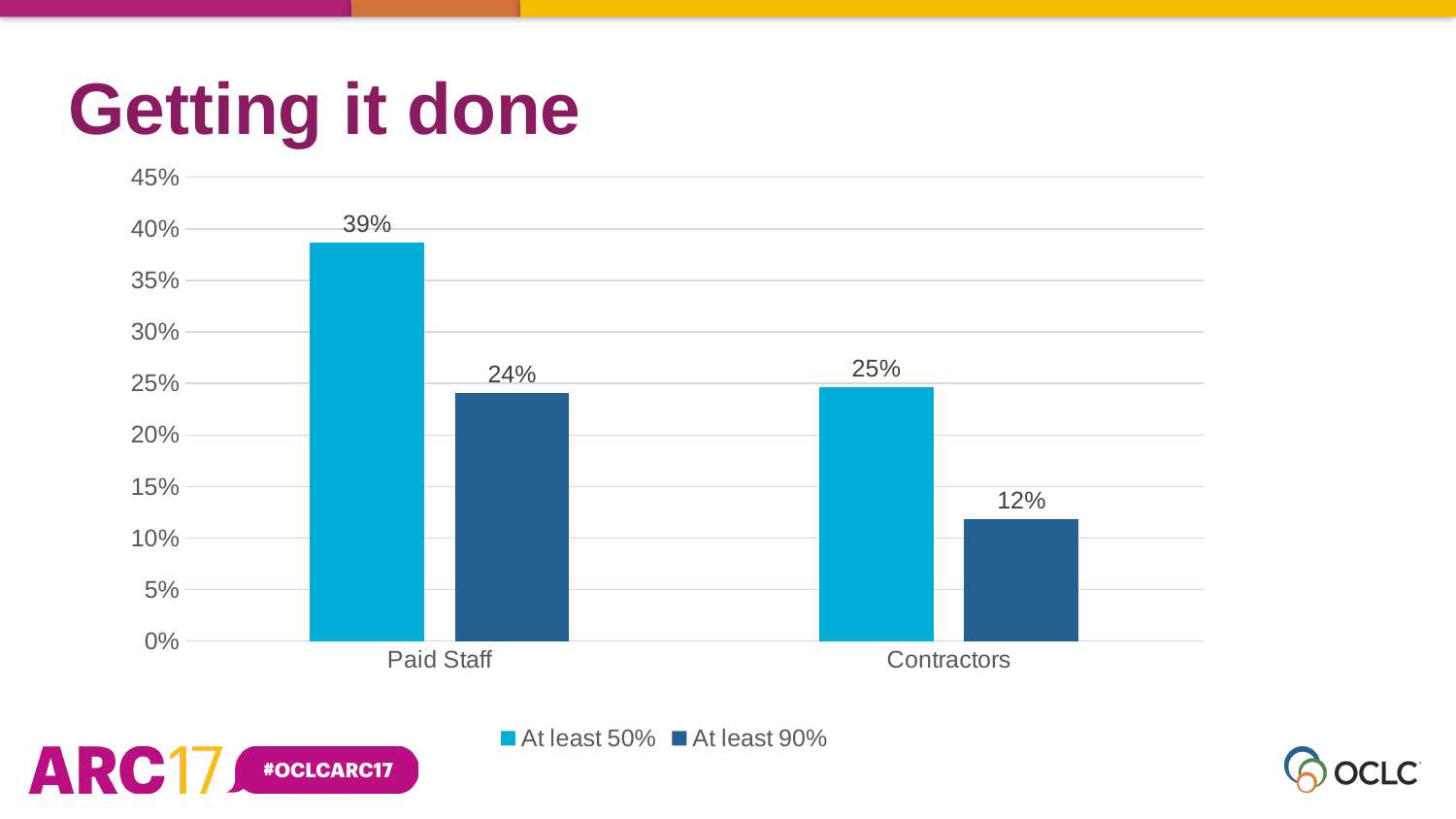
What is the value for Contractors in the At least 50% series? 25% Which category has the lowest value in the At least 90% series? Contractors Which is larger: the At least 90% value for Paid Staff or the At least 50% value for Contractors? At least 50% value for Contractors Which category has the highest value in the At least 50% series? Paid Staff What kind of chart is shown on the slide? Bar chart What is the difference between the At least 50% and At least 90% values for Paid Staff? 15% What is the value for Paid Staff in the At least 90% series? 24% How many series does the legend list? 2 What is the value for Paid Staff in the At least 50% series? 39% How many categories are shown on the x axis? 2 What is the value for Contractors in the At least 90% series? 12% What is the difference between the At least 90% values for Paid Staff and Contractors? 12%